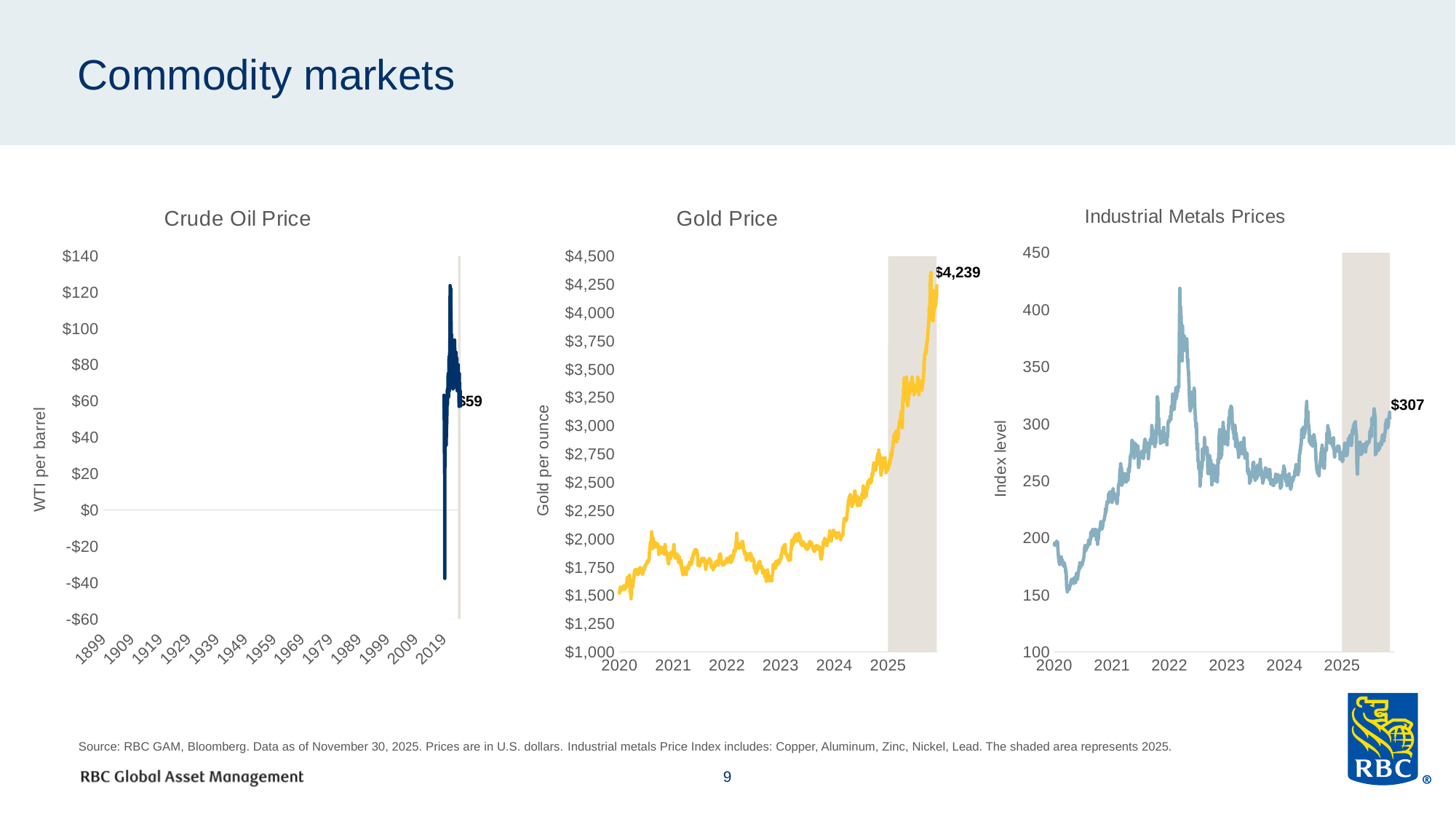
What is the y-axis label on the Industrial Metals Prices chart? Index level On the Industrial Metals Prices chart, is the value at the start of 2020 greater or less than 250? less On the Crude Oil Price chart, what is the latest value shown by the data label? $59 On the Industrial Metals Prices chart, what is the latest value shown by the data label? $307 On the Gold Price chart, what is the latest value shown by the data label? $4,239 On the Gold Price chart, is the value at the start of 2020 greater or less than $2,000? less On the Industrial Metals Prices chart, is the peak value in 2022 greater or less than 400? greater On the Gold Price chart, do values generally rise or fall from 2020 to 2025? rise What is the y-axis label on the Crude Oil Price chart? WTI per barrel What kind of chart is the Gold Price chart? line chart